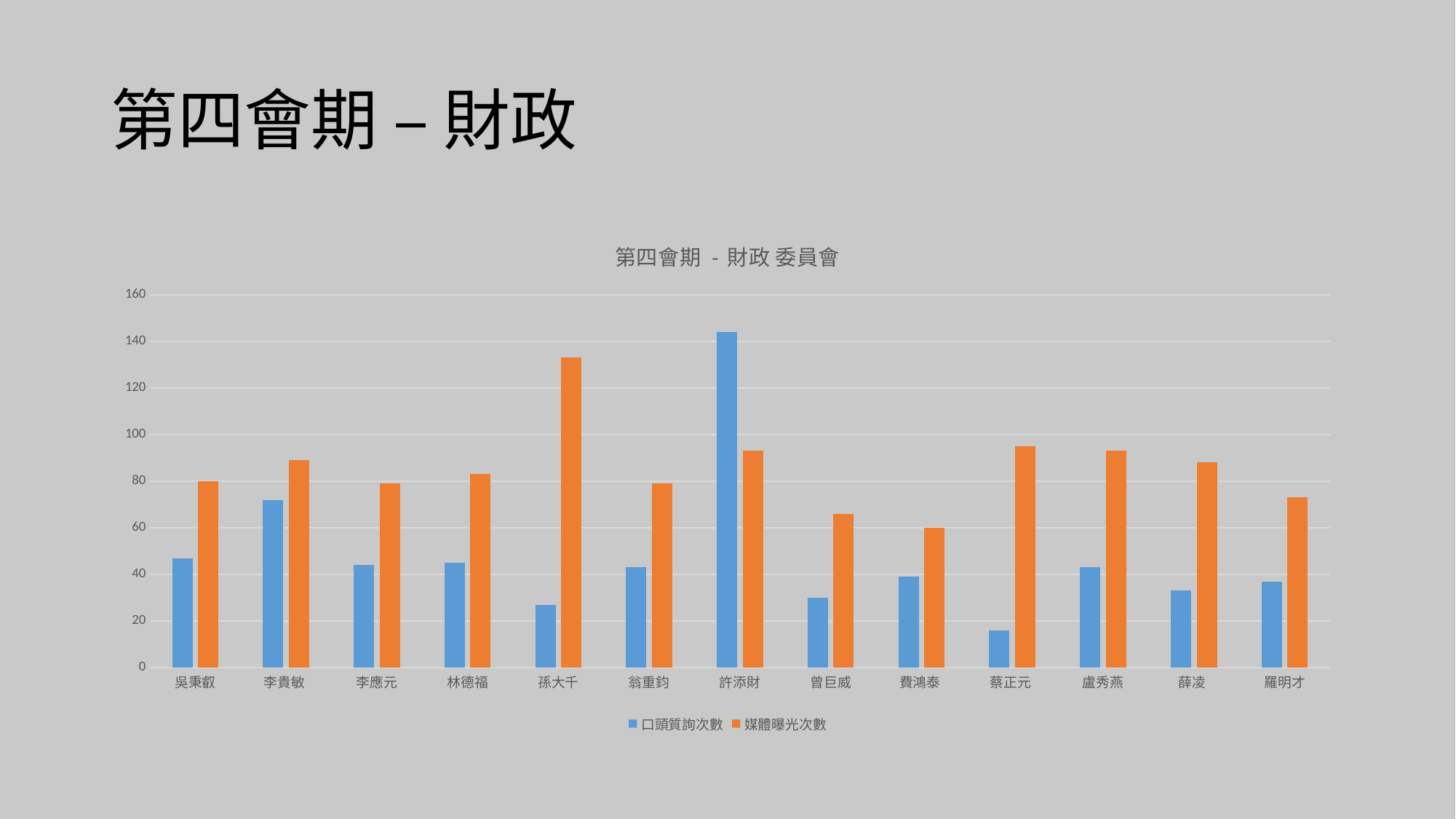
Which legislator has the highest 口頭質詢次數? 許添財 Is the 口頭質詢次數 value for 許添財 greater or less than 120? greater How many legislators (categories) are shown on the x axis? 13 What kind of chart is shown on the slide? bar chart What is the title of the chart? 第四會期 - 財政 委員會 Is the 媒體曝光次數 value for 孫大千 greater or less than 120? greater Which legislator has the highest 媒體曝光次數? 孫大千 Which legislator has the lowest 口頭質詢次數? 蔡正元 For 許添財, which is larger: 口頭質詢次數 or 媒體曝光次數? 口頭質詢次數 How many series does the legend list? 2 Is the 媒體曝光次數 value for 曾巨威 greater or less than 80? less